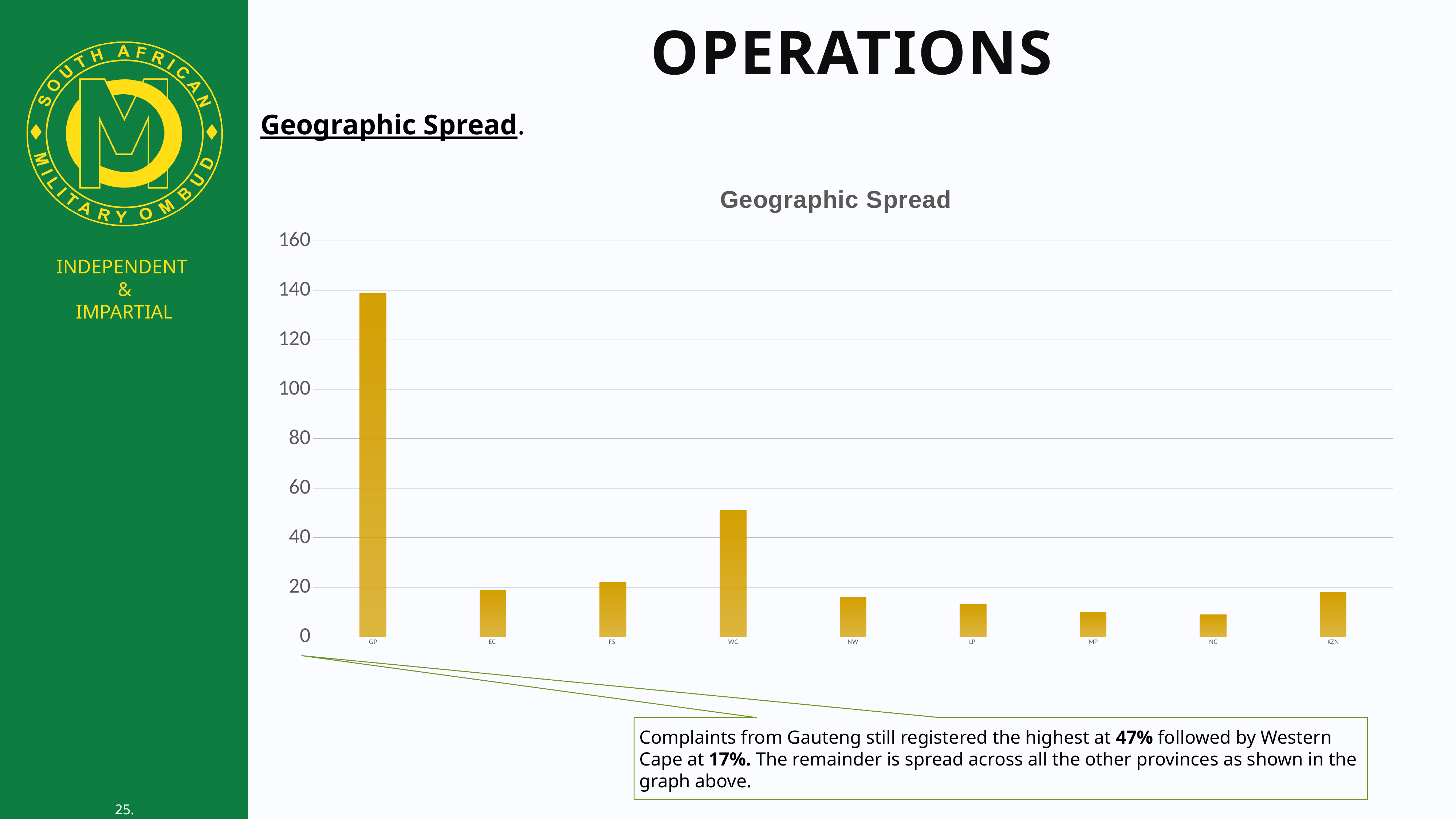
Which is larger, the value for KZN or the value for NC? KZN Is the value for WC greater or less than 40? greater Is the value for MP greater or less than 20? less Which is larger, the value for WC or the value for FS? WC What is the title of the chart? Geographic Spread What kind of chart is shown on the slide? bar chart Is the value for GP greater or less than 120? greater Which category has the highest bar in the chart? GP How many categories are shown on the x axis of the chart? 9 According to the callout below the chart, what percentage of complaints came from Gauteng? 47% Which is larger, the value for GP or the value for WC? GP